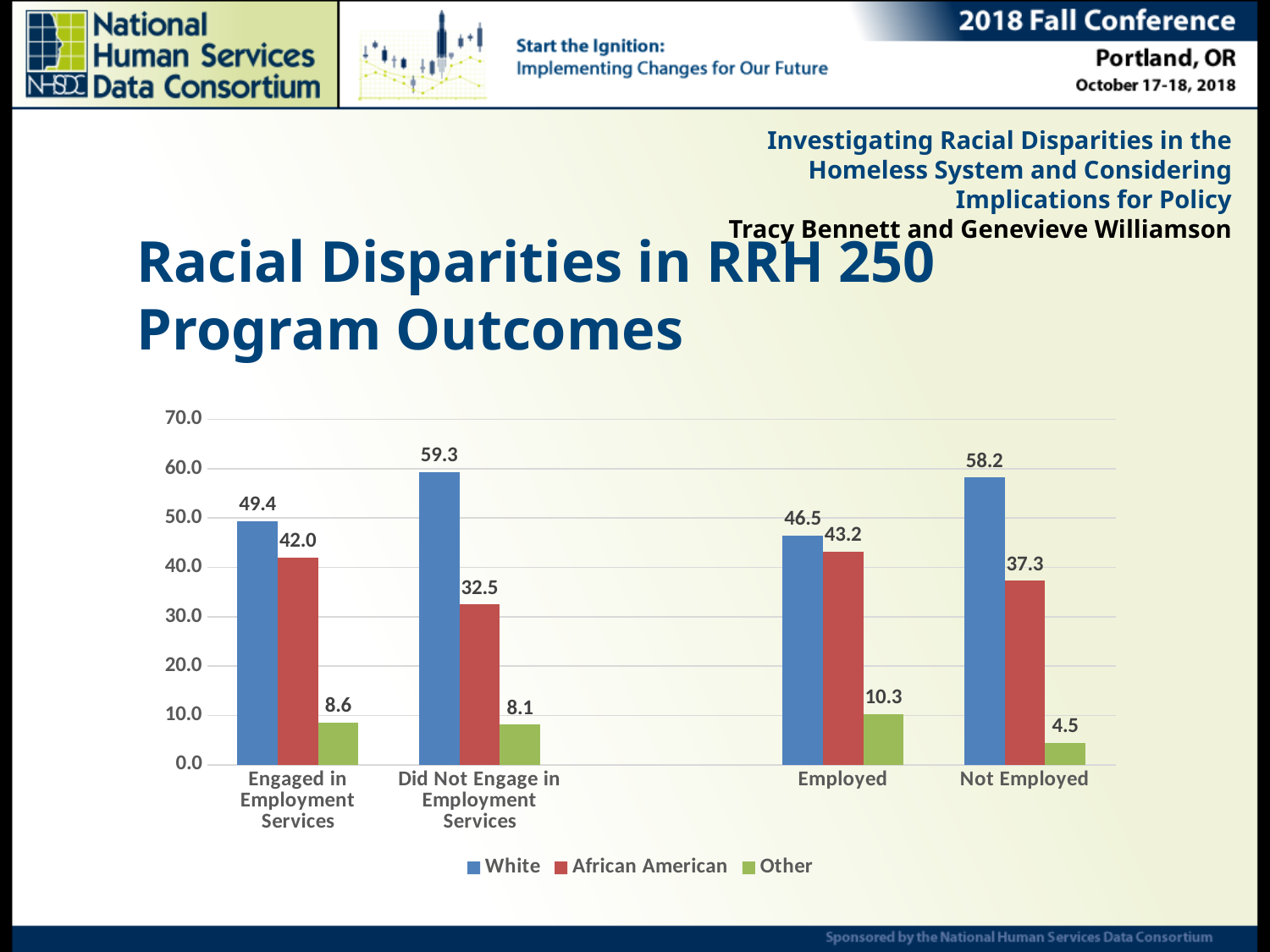
Is the value for Other in the Employed category greater or less than 10.0? greater What is the difference between the White and African American values in the Not Employed category? 20.9 What is the value for African American in the Employed category? 43.2 What kind of chart is shown on the slide? Bar chart What is the value for African American in the Did Not Engage in Employment Services category? 32.5 Which category has the highest value for the White series? Did Not Engage in Employment Services Which category has the lowest value for the Other series? Not Employed What is the value for White in the Engaged in Employment Services category? 49.4 How many series does the legend list? 3 What is the value for Other in the Not Employed category? 4.5 Which is larger in the Employed category, the White value or the African American value? White How many categories are shown on the x axis? 4